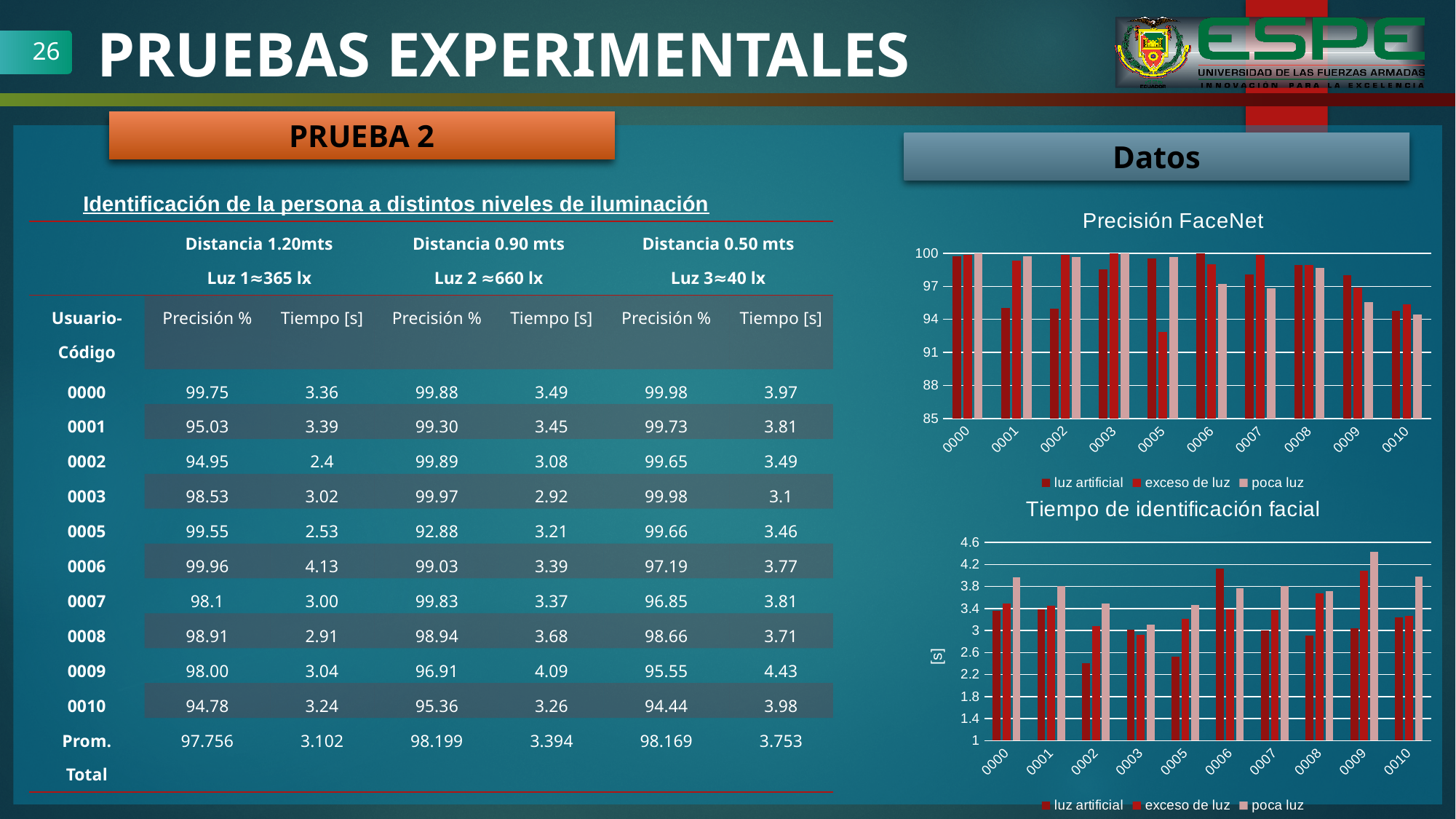
In the 'Precisión FaceNet' chart, is the 'luz artificial' value for 0001 greater or less than 94? greater In the 'Tiempo de identificación facial' chart, is the 'luz artificial' value for 0005 greater or less than 3? less How many series does the legend of the 'Precisión FaceNet' chart list? 3 In the 'Precisión FaceNet' chart, which category has the lowest 'exceso de luz' bar? 0005 In the 'Precisión FaceNet' chart, is the 'exceso de luz' value for 0005 greater or less than 94? less In the 'Tiempo de identificación facial' chart, which category has the shortest 'luz artificial' bar? 0002 In the 'Tiempo de identificación facial' chart, which category has the tallest bar overall? 0009 What kind of chart is the 'Precisión FaceNet' chart? bar chart How many user categories are shown on the x axis of the 'Tiempo de identificación facial' chart? 10 What is the y-axis label of the 'Tiempo de identificación facial' chart? [s]